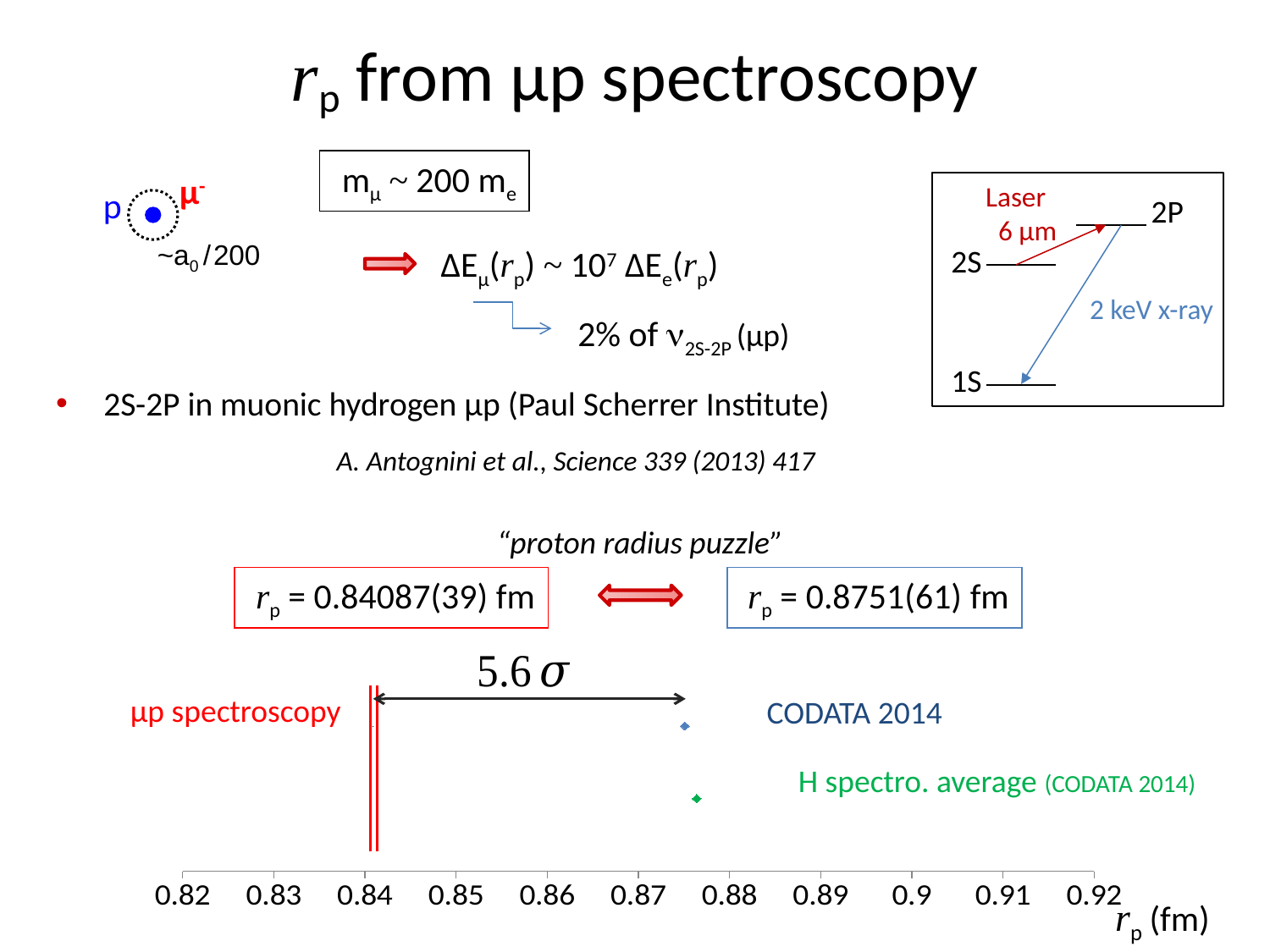
By how many standard deviations does the chart say the μp spectroscopy and CODATA 2014 values differ? 5.6σ What is the lowest tick value shown on the x axis of the bottom chart? 0.82 How many proton radius determinations are plotted on the bottom chart? 3 Which determination on the bottom chart has the lowest value of r_p? μp spectroscopy What is the highest tick value shown on the x axis of the bottom chart? 0.92 Is the r_p value for μp spectroscopy on the bottom chart greater or less than 0.85? less What quantity is plotted on the x axis of the chart at the bottom of the slide? r_p (fm) Is the r_p value for H spectro. average on the bottom chart greater or less than 0.87? greater What value of r_p is printed in the red box for the μp spectroscopy result? 0.84087(39) fm Is the r_p value for CODATA 2014 on the bottom chart greater or less than 0.87? greater Which is larger on the bottom chart, the r_p value from μp spectroscopy or from CODATA 2014? CODATA 2014 What value of r_p is printed in the blue box for the CODATA 2014 result? 0.8751(61) fm